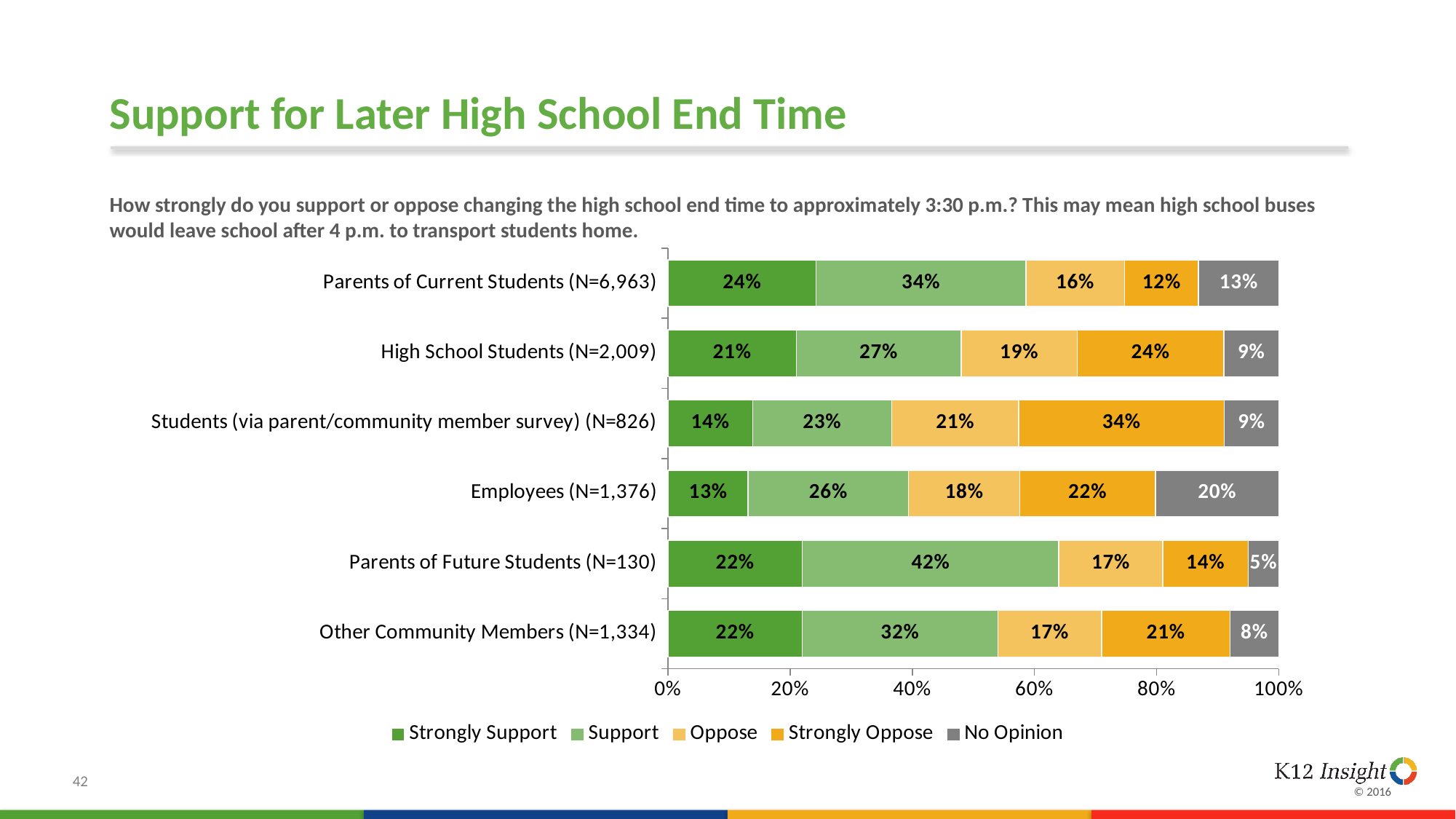
Which group has a larger No Opinion share: Employees or Other Community Members? Employees What type of chart is shown on the slide? Stacked bar chart Which group has the lowest No Opinion percentage? Parents of Future Students (N=130) How many response categories does the legend list? 5 What percentage of Parents of Current Students (N=6,963) Strongly Support the later high school end time? 24% Which group has the highest Support percentage? Parents of Future Students (N=130) What is the Oppose percentage for Employees (N=1,376)? 18% What percentage of High School Students (N=2,009) Strongly Oppose the change? 24% Which group has the highest Strongly Oppose percentage? Students (via parent/community member survey) (N=826) How many respondent groups are shown in the chart? 6 How many percentage points higher is the Strongly Oppose share for Students (via parent/community member survey) than for Parents of Current Students? 22 percentage points What colour represents the No Opinion category in the chart? Grey